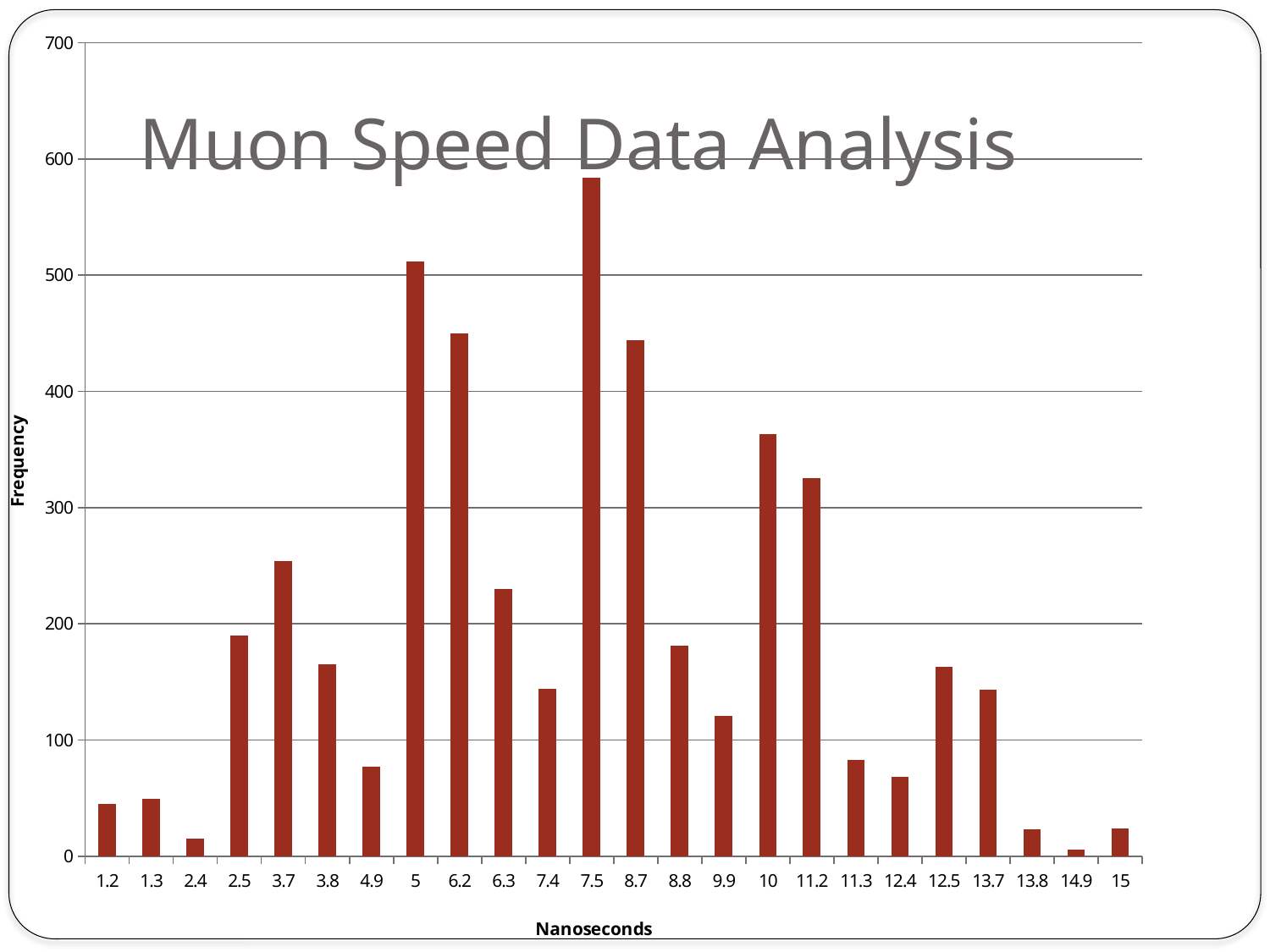
What type of chart is shown on the slide? bar chart Is the frequency for 2.4 greater or less than 100? less Is the frequency for 8.7 greater or less than 400? greater Which has a higher frequency, 5 or 6.2? 5 Is the frequency for 3.7 greater or less than 200? greater Which category has the lowest frequency? 14.9 How many categories are shown on the x axis? 24 What is the title of the chart? Muon Speed Data Analysis Which has a higher frequency, 10 or 11.2? 10 What is the label of the vertical axis? Frequency Which category has the highest frequency? 7.5